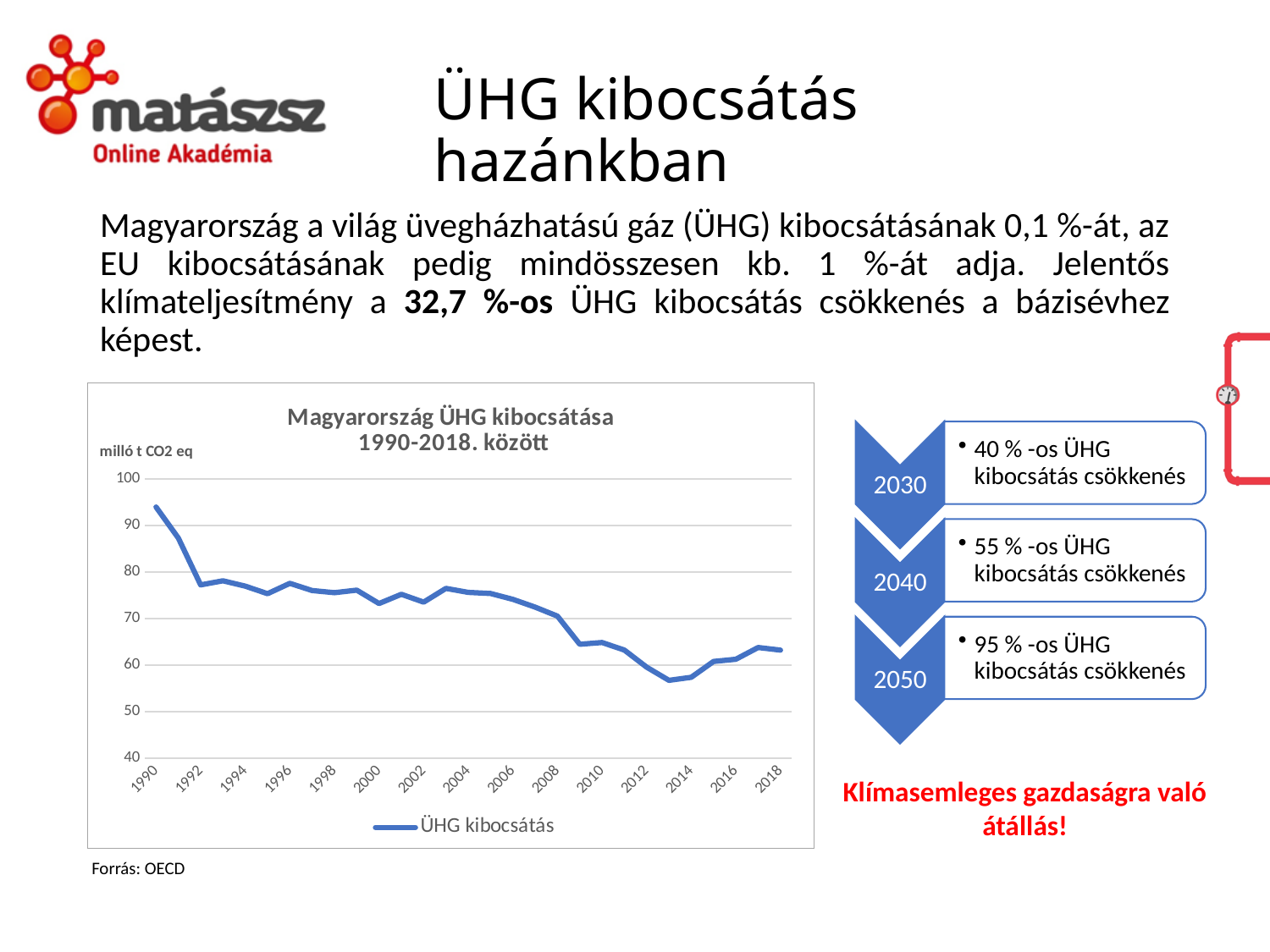
What kind of chart is shown on the slide? line chart How many years are labelled on the x axis of the chart? 15 How many series does the chart legend list? 1 Overall, do the ÜHG kibocsátás values rise or fall from 1990 to 2018? fall Is the ÜHG kibocsátás value for 2013 greater or less than 60? less Is the ÜHG kibocsátás value for 1990 greater or less than 90? greater Which year has the larger ÜHG kibocsátás value, 1990 or 2018? 1990 Is the ÜHG kibocsátás value for 2018 greater or less than 60? greater What is the name of the series shown in the chart legend? ÜHG kibocsátás What is the title of the chart? Magyarország ÜHG kibocsátása 1990-2018. között Which year has the highest ÜHG kibocsátás value in the chart? 1990